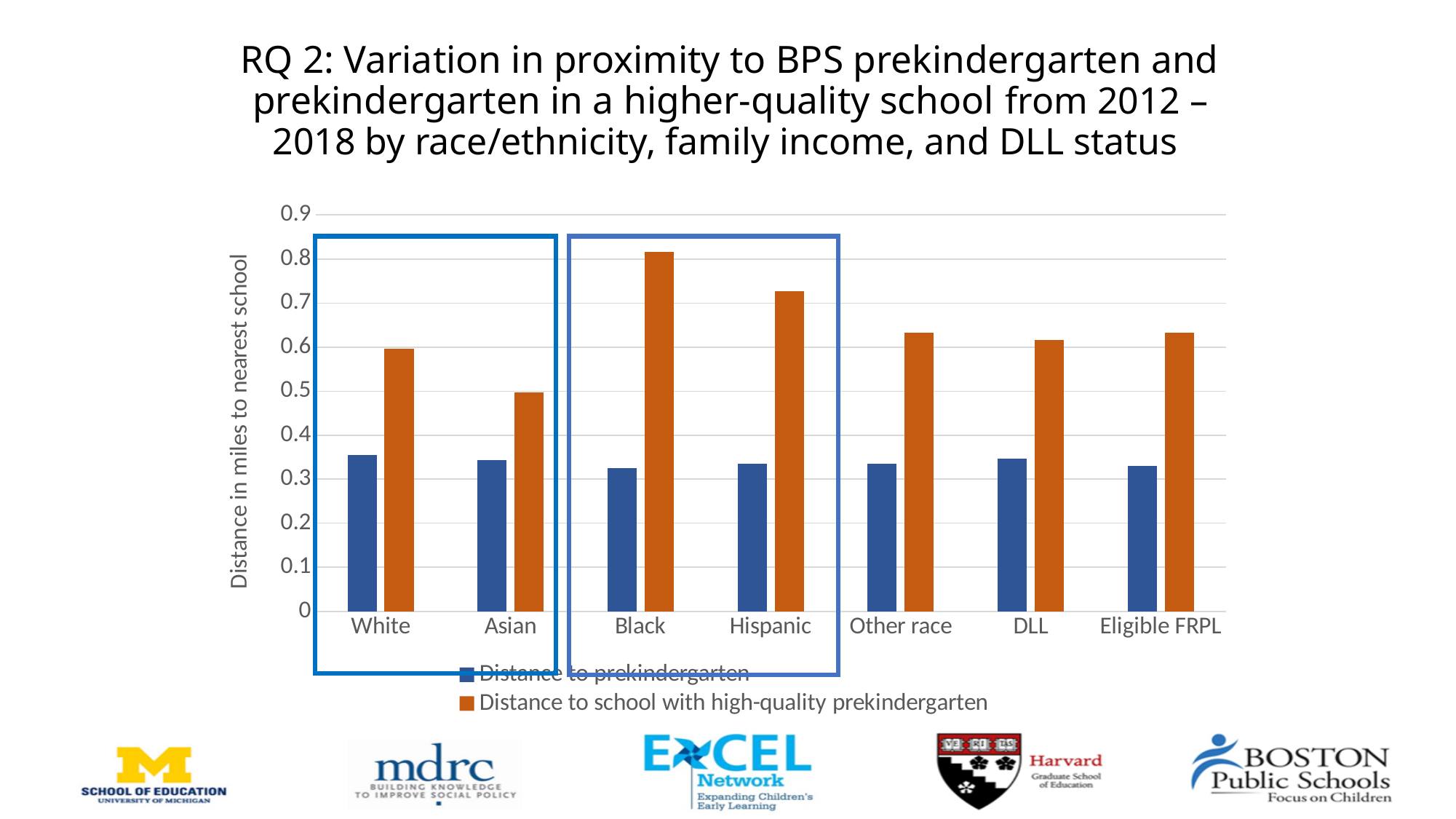
What kind of chart is shown on the slide? bar chart Is the 'Distance to school with high-quality prekindergarten' value for Asian greater or less than 0.6? less Which category has the lowest value for 'Distance to school with high-quality prekindergarten'? Asian Is the 'Distance to school with high-quality prekindergarten' value for Black greater or less than 0.7? greater Is the 'Distance to school with high-quality prekindergarten' value for Hispanic greater or less than 0.7? greater What is the label of the chart's vertical axis? Distance in miles to nearest school How many series does the chart's legend list? 2 Which is larger for 'Distance to school with high-quality prekindergarten': Black or Hispanic? Black Which category has the highest value for 'Distance to school with high-quality prekindergarten'? Black How many categories are shown on the x axis of the chart? 7 For the DLL category, which series has the larger value: 'Distance to prekindergarten' or 'Distance to school with high-quality prekindergarten'? Distance to school with high-quality prekindergarten